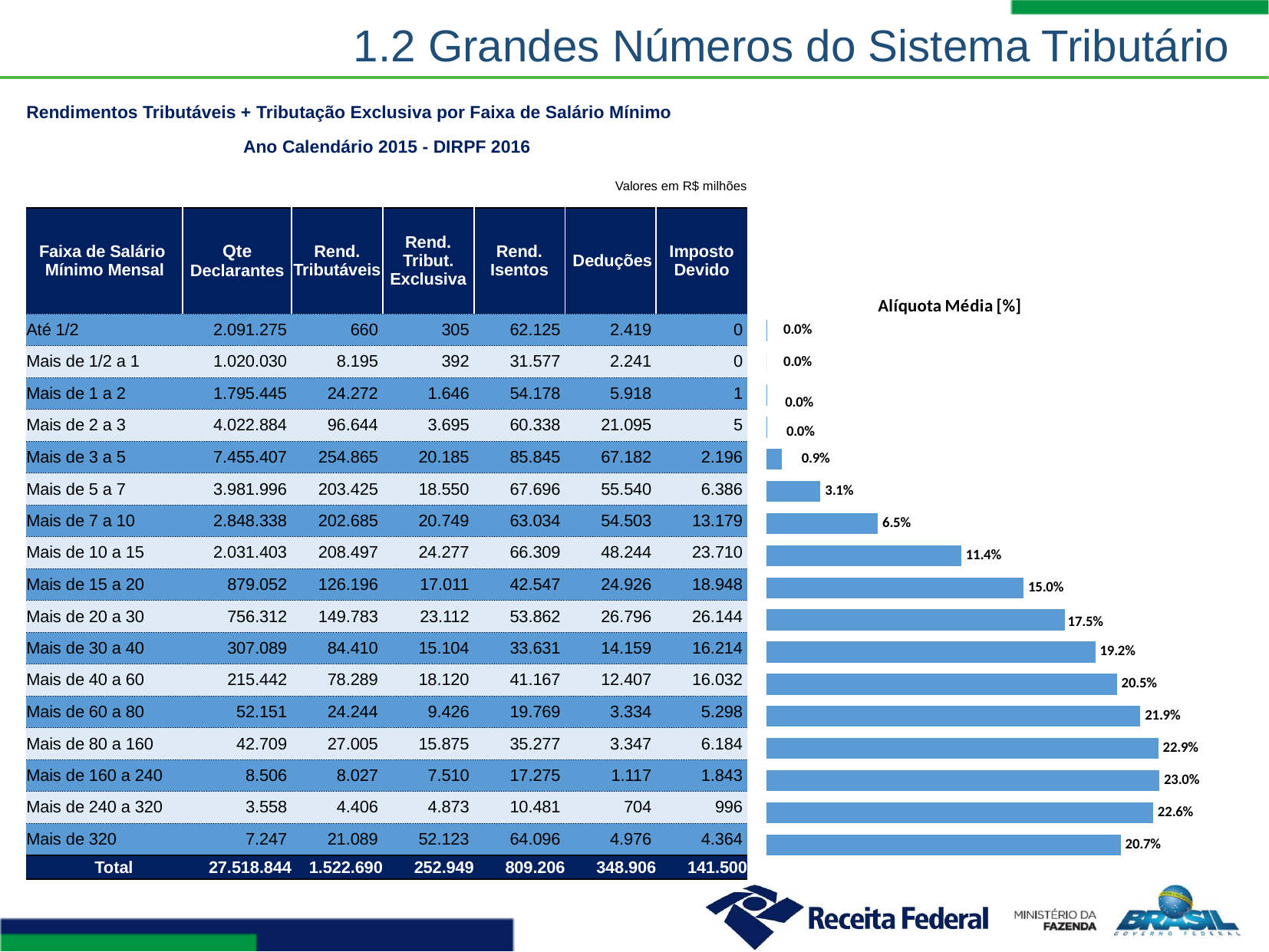
What is the value labelled on the bottom bar of the Alíquota Média [%] chart? 20.7% In the Alíquota Média [%] chart, which is larger: the bar aligned with 'Mais de 80 a 160' or the bar aligned with 'Mais de 240 a 320'? Mais de 80 a 160 (22.9%) In the Alíquota Média [%] chart, what is the value of the bar aligned with the table row 'Mais de 5 a 7'? 3.1% In the Alíquota Média [%] chart, what is the value of the bar aligned with the table row 'Mais de 10 a 15'? 11.4% What kind of chart is shown on the right side of the slide? bar chart In the Alíquota Média [%] chart, do the values generally rise or fall going down from the first bar to the bar labelled 23.0%? rise What is the title of the chart on the right side of the slide? Alíquota Média [%] What is the highest value labelled in the Alíquota Média [%] chart? 23.0% How many bars in the Alíquota Média [%] chart are labelled 0.0%? 4 How many bars does the Alíquota Média [%] chart contain? 17 What is the lowest value labelled in the Alíquota Média [%] chart? 0.0% In the Alíquota Média [%] chart, what is the difference between the bar labelled 15.0% and the bar labelled 11.4%? 3.6 percentage points